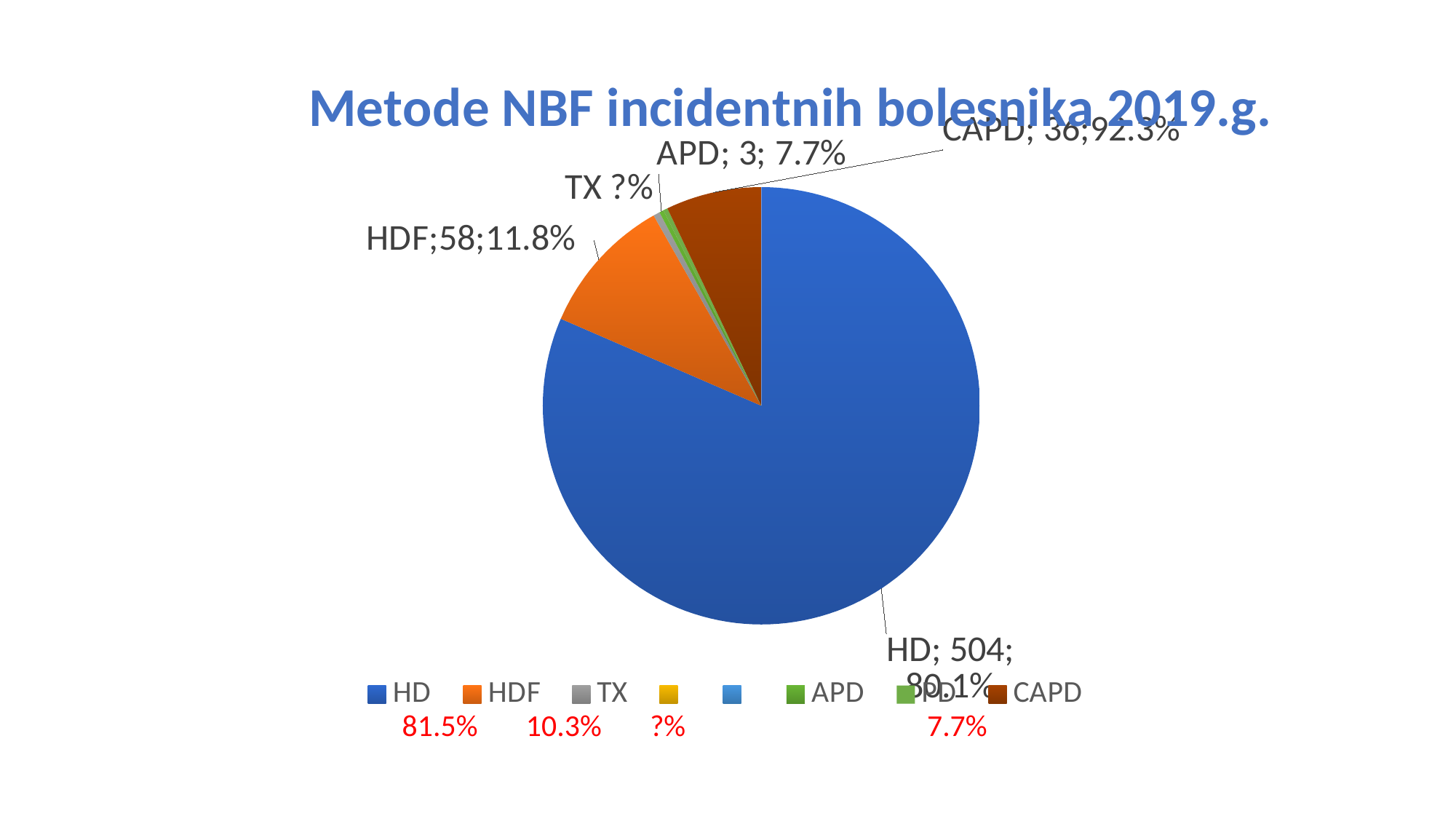
What is the title of the chart? Metode NBF incidentnih bolesnika 2019.g. Which category has the largest slice of the pie? HD How many patients are in the APD slice? 3 What percentage is shown on the data label for the HDF slice? 11.8% Which has more patients, HDF or CAPD? HDF What kind of chart is shown on the slide? pie chart How many patients are in the HD slice? 504 How many patients are in the CAPD slice? 36 What is the difference in patient count between HD and HDF? 446 What colour is the HD slice? blue How many patients are in the HDF slice? 58 What percentage is shown on the data label for the HD slice? 80.1%